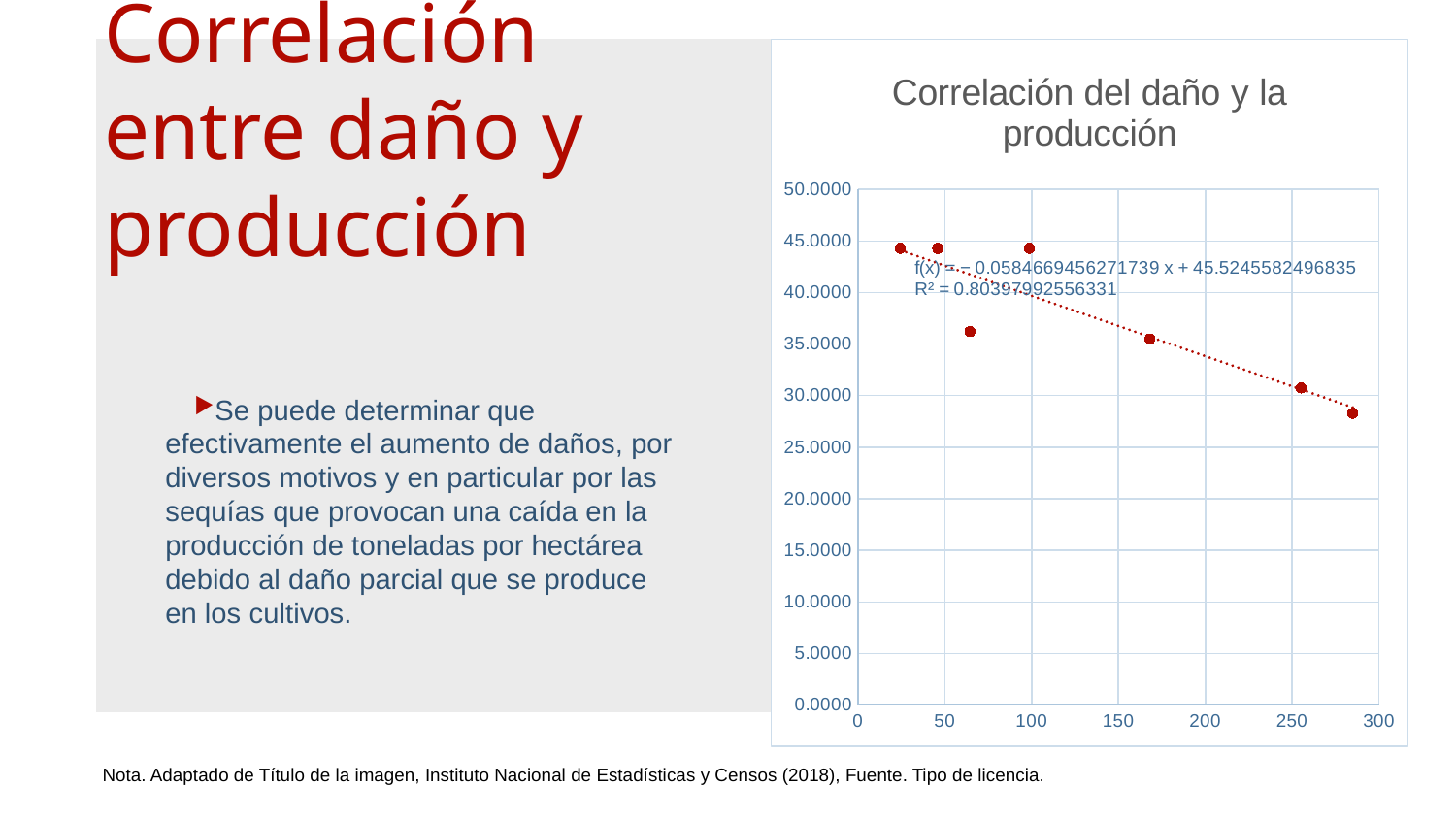
What is the title of the chart on the slide? Correlación del daño y la producción What kind of chart is shown on the slide? scatter chart How many data points are plotted in the chart 'Correlación del daño y la producción'? 7 Which point has the lowest y value: the leftmost point or the rightmost point? the rightmost point Do the plotted values rise or fall as the x value increases in the chart? fall What trendline equation is printed on the chart? f(x) = -0.0584669456271739 x + 45.5245582496835 Is the y value of the rightmost point (near x = 285) greater or less than 30? less What is the highest value shown on the y axis of the chart? 50.0000 Which has the larger y value: the point near x = 65 or the point near x = 285? the point near x = 65 What R² value is printed on the chart for the trendline? R² = 0.80397992556331 Is the y value of the leftmost point (near x = 25) greater or less than 40? greater Is the y value of the point near x = 65 greater or less than 35? greater